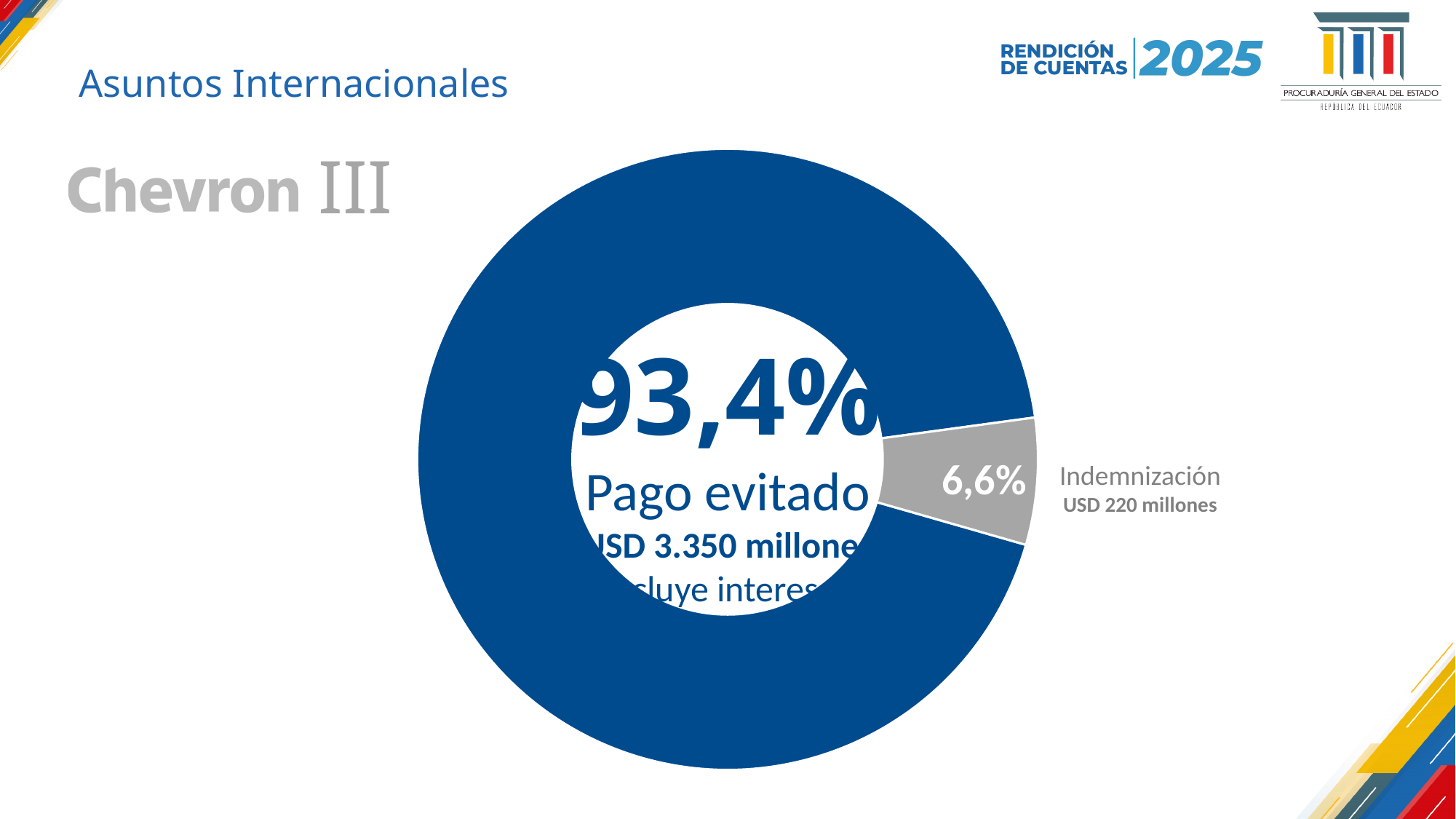
What is the title shown next to the chart? Chevron III What share of the pie does the Pago evitado slice represent? 93,4% Which is larger, the Pago evitado share or the Indemnización share? Pago evitado What is the difference in percentage points between the Pago evitado share and the Indemnización share? 86,8 What share of the pie does the Indemnización slice represent? 6,6% What amount is shown for Pago evitado? USD 3.350 millones How many slices does the pie chart have? 2 Which slice of the pie is the smallest? Indemnización Which slice of the pie is the largest? Pago evitado What colour is the Indemnización slice? grey What amount is shown for Indemnización? USD 220 millones What kind of chart is shown on the slide? doughnut chart